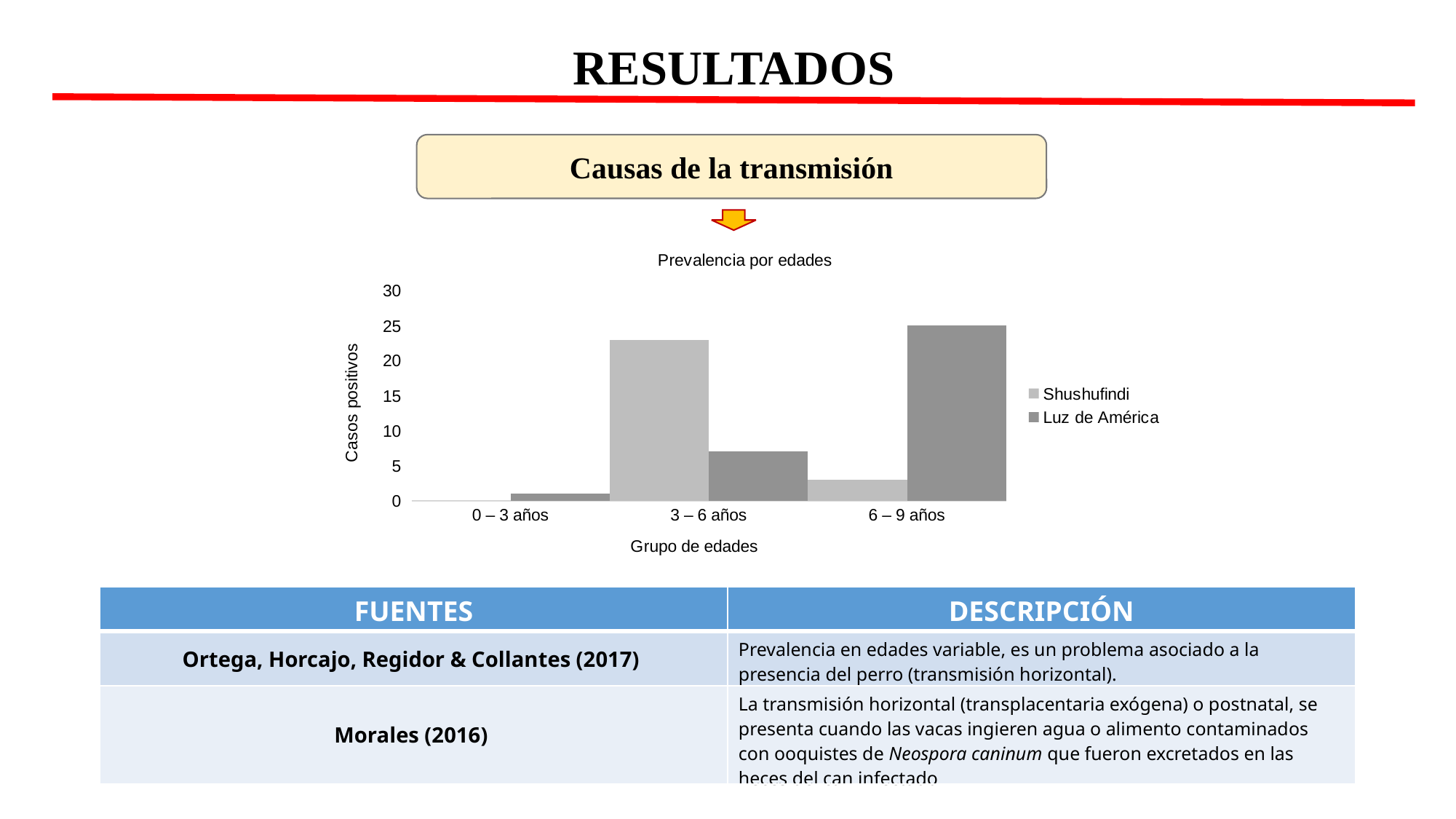
In the 'Prevalencia por edades' chart, is the Luz de América value for 3 – 6 años greater or less than 10? less In the 'Prevalencia por edades' chart, for the 3 – 6 años group, which series has the larger value, Shushufindi or Luz de América? Shushufindi What is the y-axis title of the 'Prevalencia por edades' chart? Casos positivos In the 'Prevalencia por edades' chart, which age group has the lowest value for Luz de América? 0 – 3 años How many series does the legend of the 'Prevalencia por edades' chart list? 2 In the 'Prevalencia por edades' chart, which age group has the highest value for Shushufindi? 3 – 6 años In the 'Prevalencia por edades' chart, for the 6 – 9 años group, which series has the larger value, Shushufindi or Luz de América? Luz de América In the 'Prevalencia por edades' chart, is the Shushufindi value for 3 – 6 años greater or less than 20? greater What kind of chart is 'Prevalencia por edades'? bar chart In the 'Prevalencia por edades' chart, do the Luz de América values rise or fall from 0 – 3 años to 6 – 9 años? rise In the 'Prevalencia por edades' chart, which age group has the highest value for Luz de América? 6 – 9 años How many age groups are shown on the x axis of the 'Prevalencia por edades' chart? 3